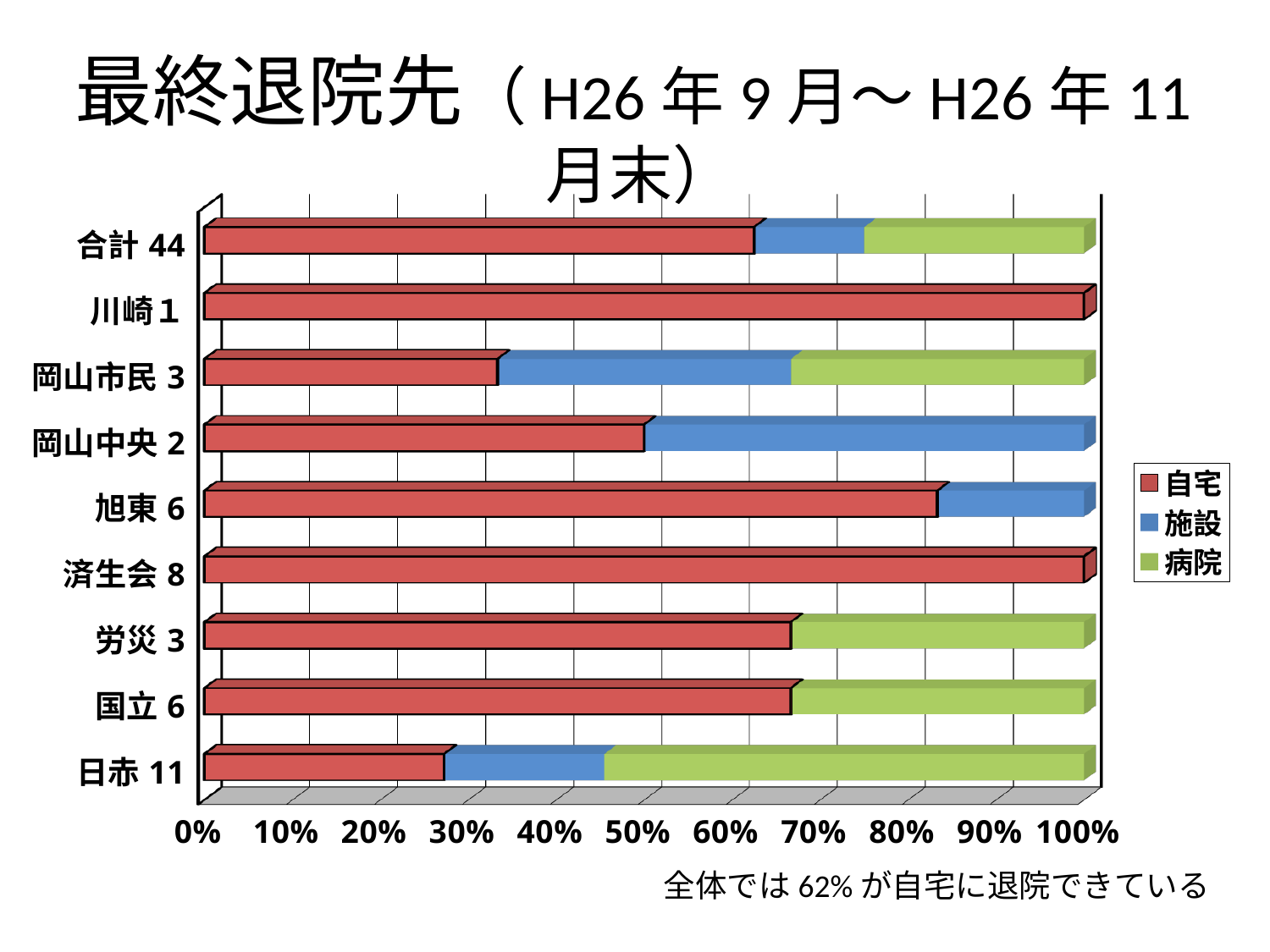
Which has the larger 自宅 share, 旭東 6 or 日赤 11? 旭東 6 According to the note on the slide, what percentage of all patients were discharged to 自宅? 62% Is the 自宅 share for 日赤 11 greater or less than 30%? less Is the 自宅 share for 合計 44 greater or less than 60%? greater How many categories (bars) are plotted on the chart? 9 Is the 自宅 share for 旭東 6 greater or less than 80%? greater Which category has the lowest 自宅 share? 日赤 11 What kind of chart is shown on the slide? stacked bar chart How many series does the legend list? 3 Which colour represents 自宅 in the chart? red What are the three series named in the legend? 自宅, 施設, 病院